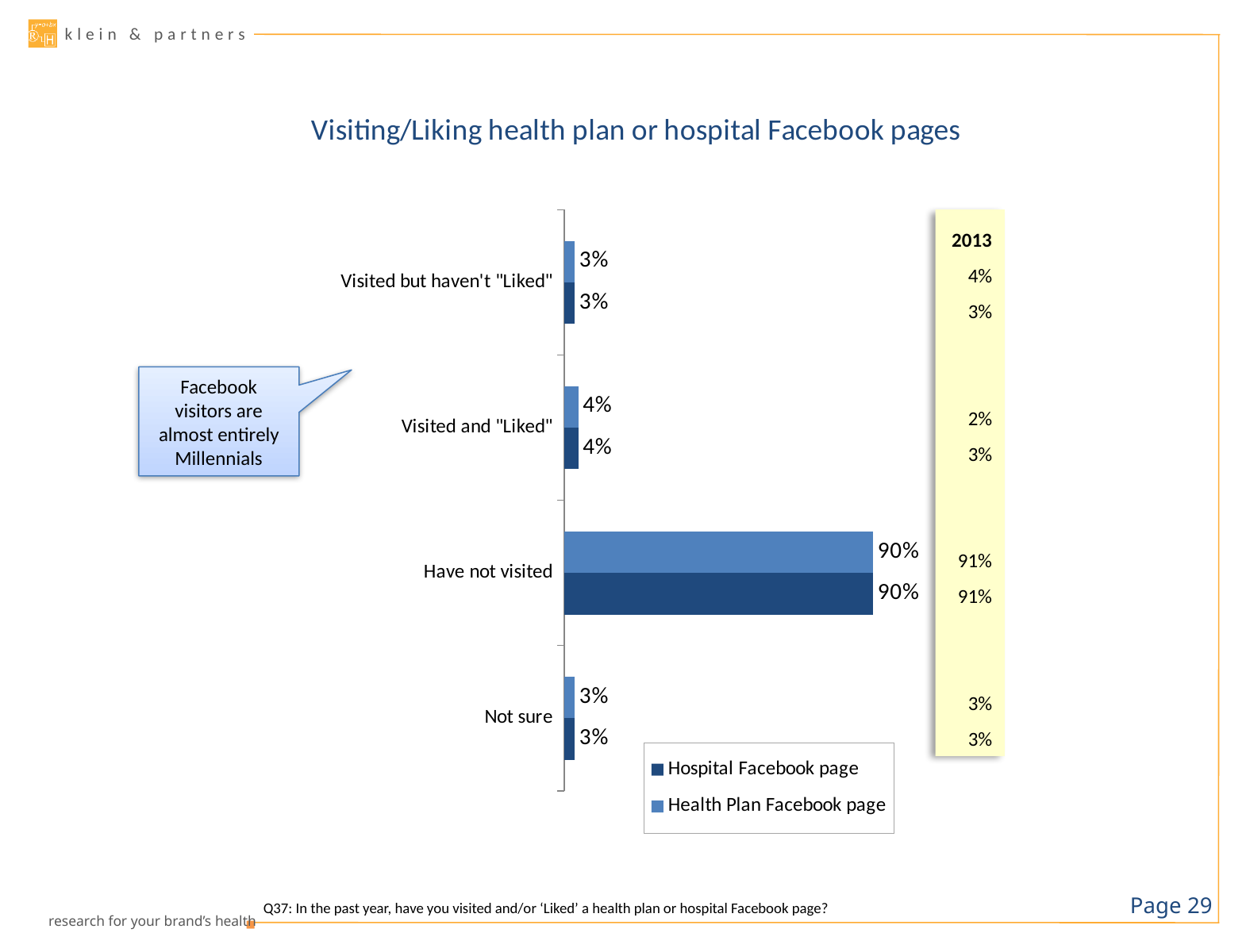
What kind of chart is shown on the slide? Bar chart What is the title of the chart? Visiting/Liking health plan or hospital Facebook pages What is the difference between the Hospital Facebook page values for "Have not visited" and "Visited and "Liked""? 86% What is the value for Health Plan Facebook page in the "Not sure" category? 3% For Health Plan Facebook page, which is larger: "Visited and "Liked"" or "Not sure"? Visited and "Liked" Which category has the highest value for Hospital Facebook page? Have not visited What is the value for Health Plan Facebook page in the "Visited and "Liked"" category? 4% What is the difference between the Health Plan Facebook page values for "Have not visited" and "Not sure"? 87% How many categories are shown on the chart? 4 What is the value for Hospital Facebook page in the "Have not visited" category? 90% What is the value for Hospital Facebook page in the "Visited but haven't "Liked"" category? 3% How many series does the legend list? 2